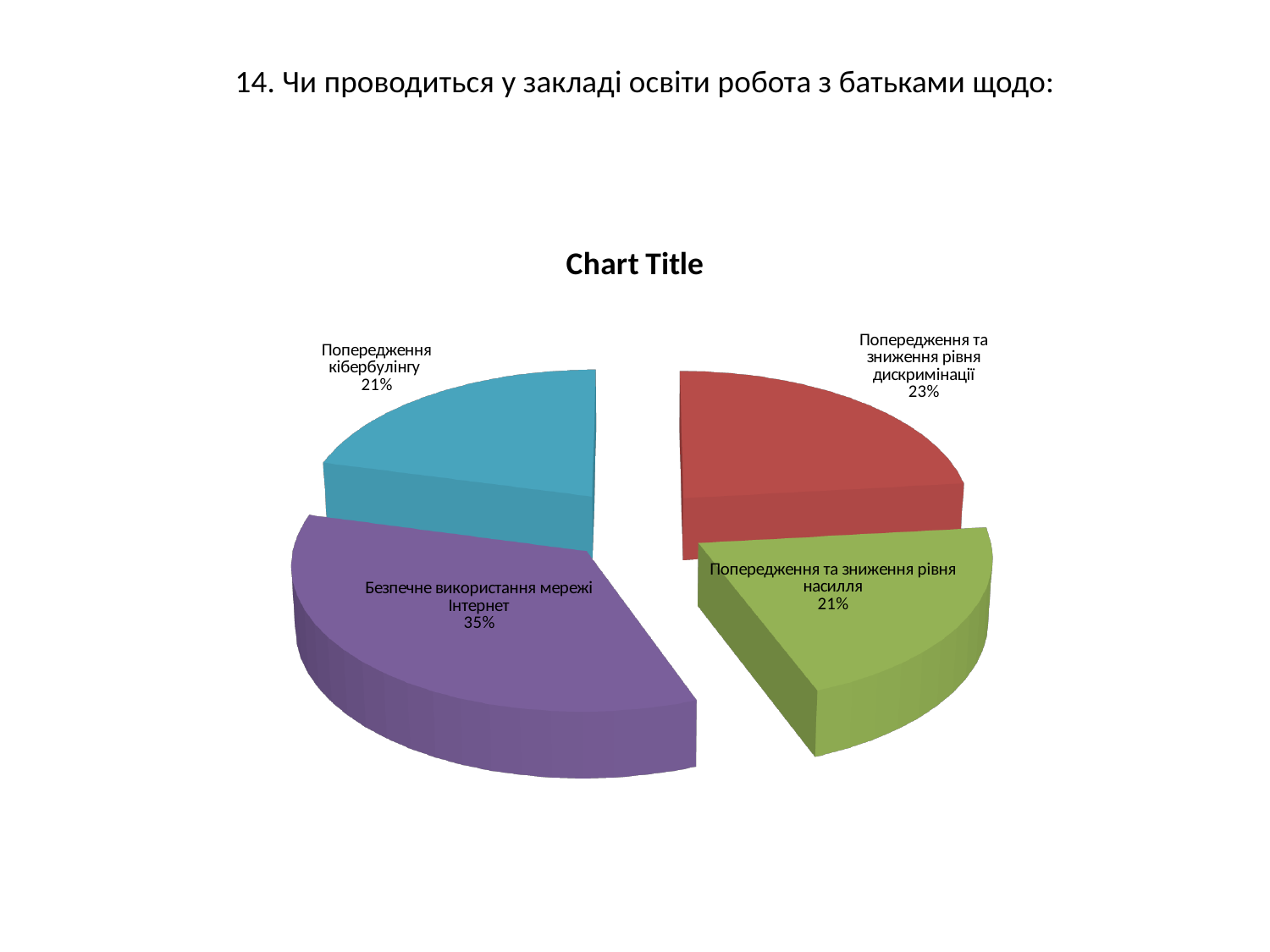
What is the difference in percentage points between "Попередження та зниження рівня дискримінації" and "Попередження та зниження рівня насилля"? 2 What is the title printed above the pie chart? Chart Title What share of the pie does "Безпечне використання мережі Інтернет" have? 35% What share of the pie does "Попередження та зниження рівня насилля" have? 21% How many slices does the pie chart have? 4 What share of the pie does "Попередження та зниження рівня дискримінації" have? 23% Which category has the largest slice of the pie? Безпечне використання мережі Інтернет What is the difference in percentage points between "Безпечне використання мережі Інтернет" and "Попередження та зниження рівня дискримінації"? 12 What kind of chart is shown on the slide? pie chart Which is larger: the share for "Попередження та зниження рівня дискримінації" or the share for "Попередження кібербулінгу"? Попередження та зниження рівня дискримінації What colour is the slice for "Безпечне використання мережі Інтернет"? purple